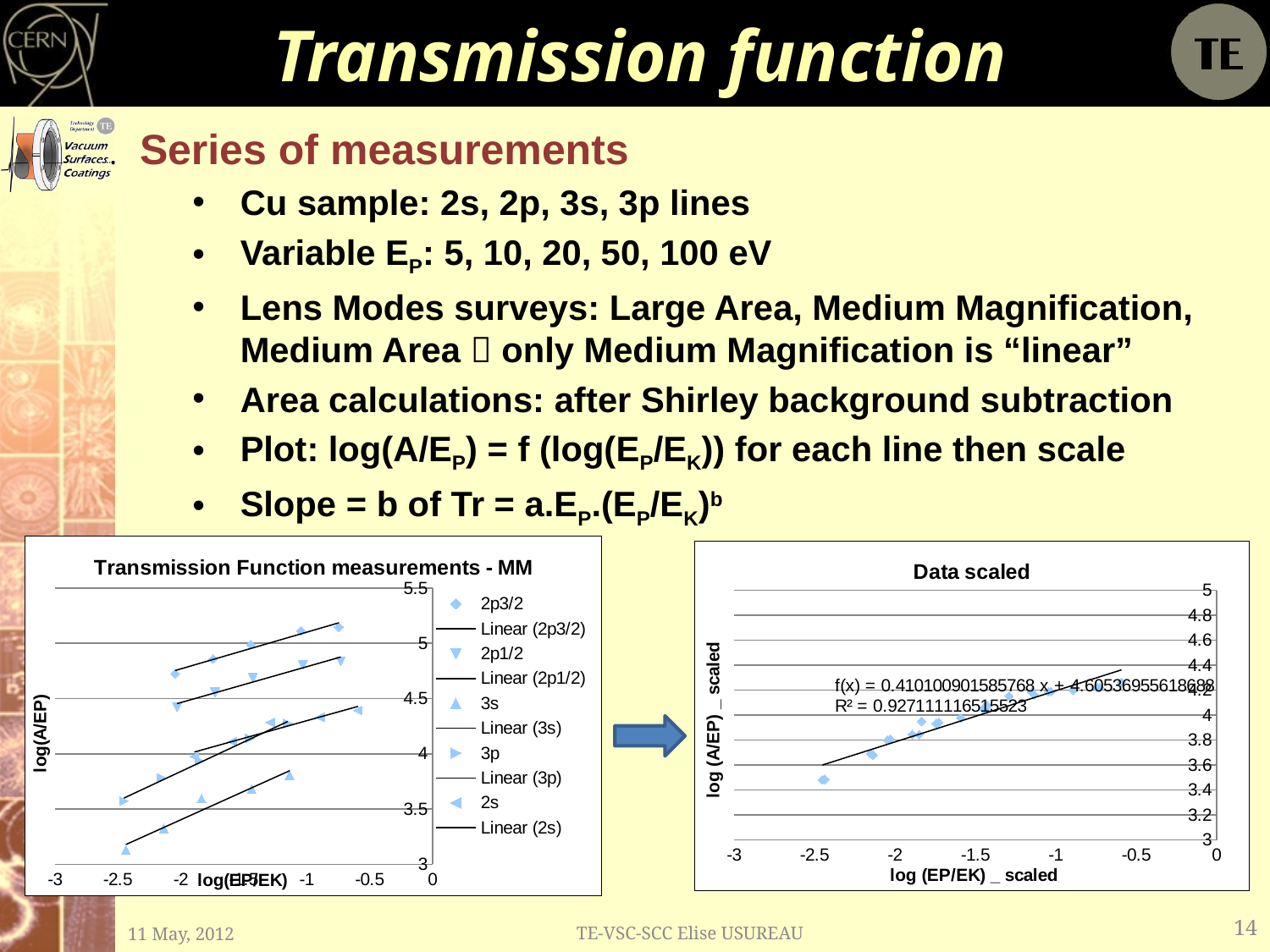
In the 'Transmission Function measurements - MM' chart, how many entries does the legend list? 10 In the 'Transmission Function measurements - MM' chart, do the 2p3/2 values rise or fall as log(EP/EK) increases? rise In the 'Data scaled' chart, what is the R² value printed on the chart? 0.927111116515523 In the 'Data scaled' chart, do the plotted values rise or fall as log (EP/EK) _ scaled increases? rise What kind of chart is the 'Data scaled' chart on the right? scatter chart In the 'Transmission Function measurements - MM' chart, how many data series (excluding the linear fits) are plotted? 5 What is the y-axis label of the 'Data scaled' chart? log (A/EP) _ scaled In the 'Data scaled' chart, what is the slope of the fitted line f(x) shown on the chart? 0.410100901585768 What kind of chart is the 'Transmission Function measurements - MM' chart on the left? scatter chart In the 'Transmission Function measurements - MM' chart, are the 2p3/2 values greater or less than 4.5? greater In the 'Data scaled' chart, what is the intercept of the fitted line f(x) shown on the chart? 4.60536955618688